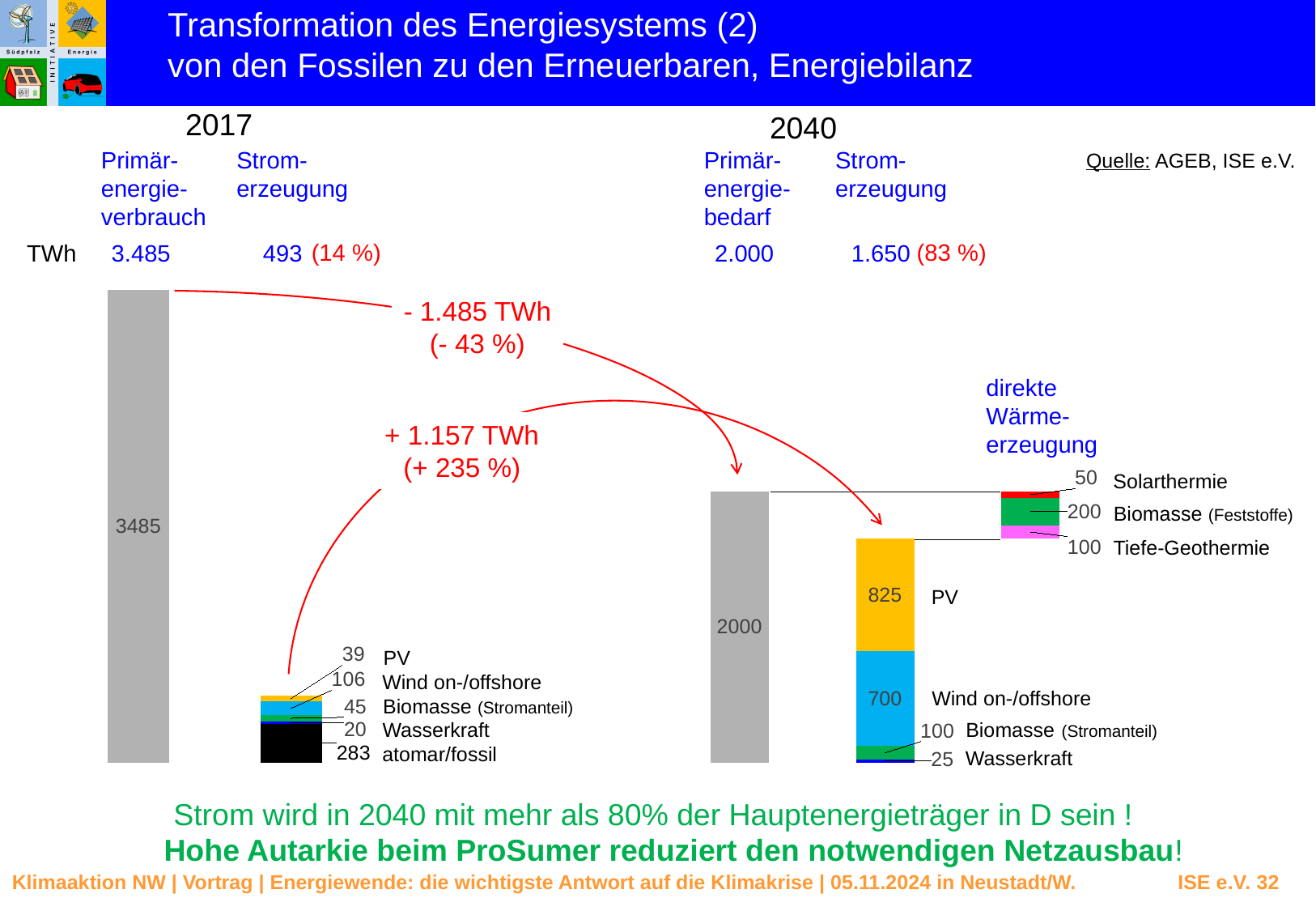
In the 2040 chart, what is the value for Tiefe-Geothermie in the direkte Wärmeerzeugung bar? 100 In the 2017 chart, which segment of the Stromerzeugung bar is the largest? atomar/fossil In the 2040 chart, which is larger: PV or Wind on-/offshore? PV How many segments does the 2017 Stromerzeugung bar have? 5 What is the difference between the Primärenergie bar for 2017 (3485) and for 2040 (2000)? 1485 In the 2017 chart, which segment of the Stromerzeugung bar is the smallest? Wasserkraft In the 2040 chart, what is the total of the direkte Wärmeerzeugung bar (Solarthermie, Biomasse, Tiefe-Geothermie)? 350 In the 2017 chart, what is the value for atomar/fossil in the Stromerzeugung bar? 283 In the 2040 chart, which segment of the Stromerzeugung bar is the smallest? Wasserkraft What kind of chart is used to show the energy values on this slide? Stacked bar chart In the 2040 chart, what is the value for Wind on-/offshore? 700 In the 2040 chart, what is the value for PV in the Stromerzeugung bar? 825